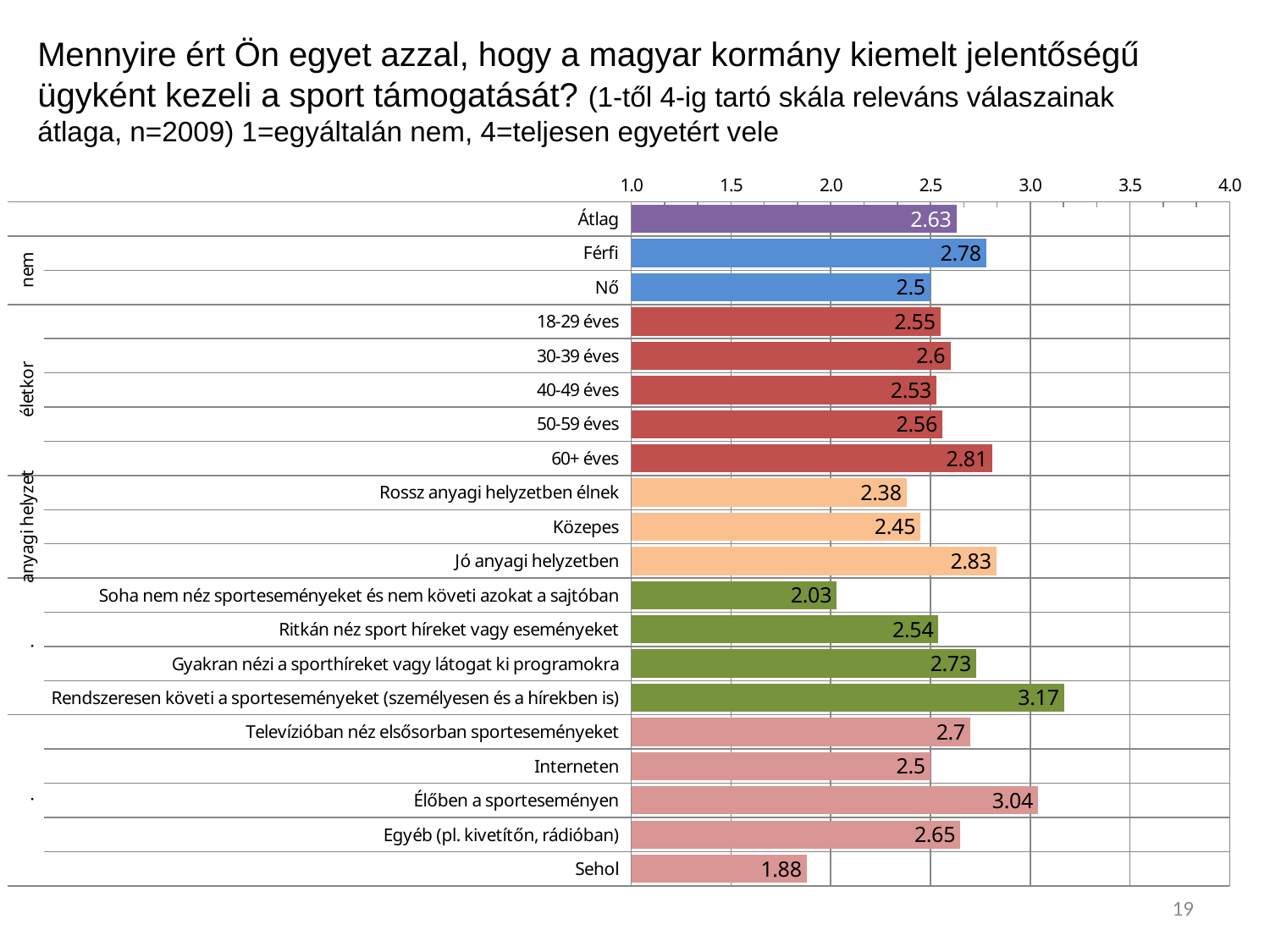
What is the value for Férfi? 2.78 Is the value for Élőben a sporteseményen greater or less than 3.0? greater What kind of chart is shown on the slide? bar chart What is the value for Átlag? 2.63 Which is larger, the value for 60+ éves or the value for 18-29 éves? 60+ éves What is the difference between the values for Jó anyagi helyzetben and Rossz anyagi helyzetben élnek? 0.45 Which category has the lowest value? Sehol What is the difference between the values for Férfi and Nő? 0.28 Which category has the highest value? Rendszeresen követi a sporteseményeket (személyesen és a hírekben is) What is the value for Sehol? 1.88 How many bars are shown in the chart? 20 What is the value for Jó anyagi helyzetben? 2.83